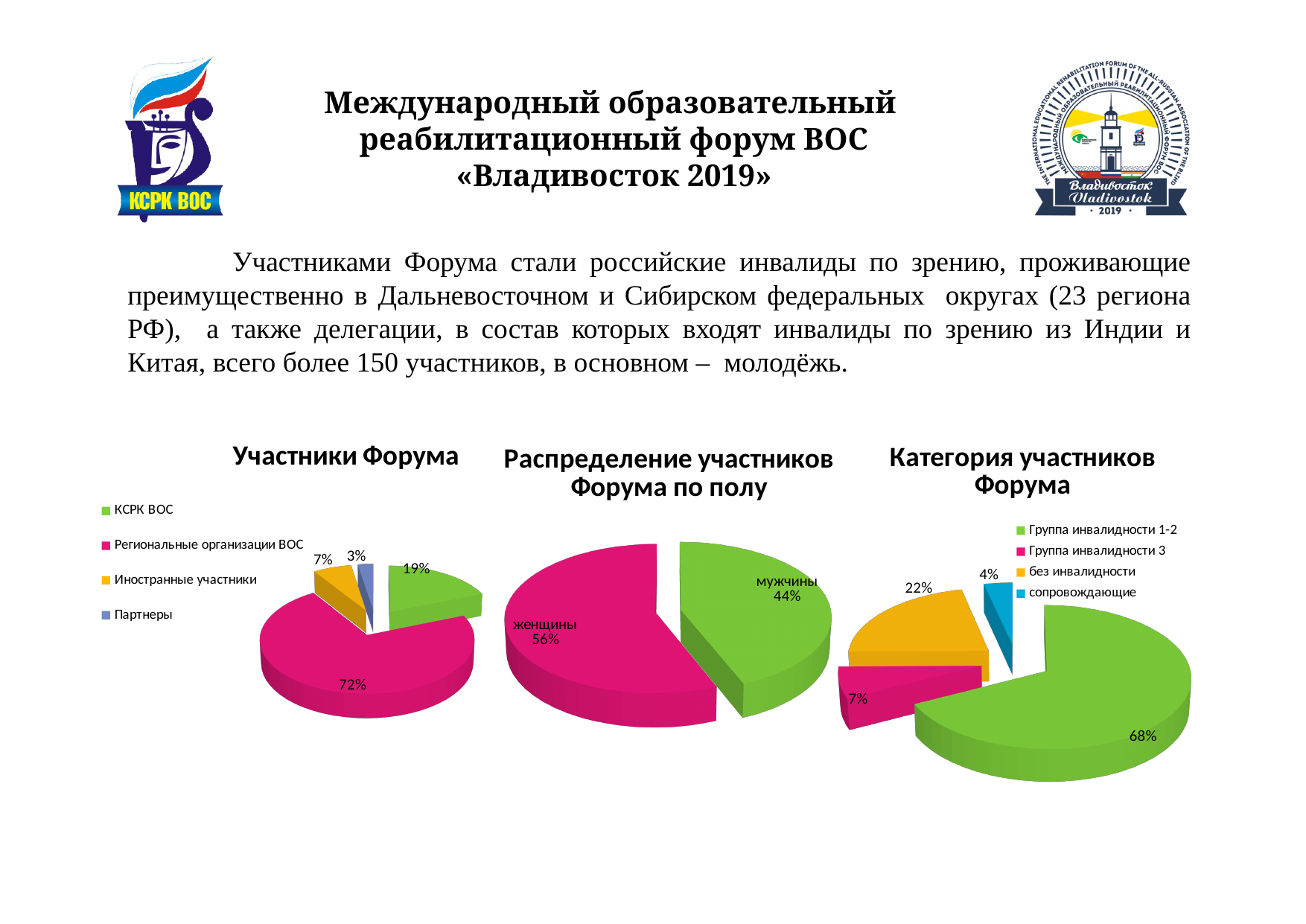
What kind of chart is «Категория участников Форума»? Pie chart In the chart titled «Распределение участников Форума по полу», what is the difference between the shares of «женщины» and «мужчины»? 12% In the chart titled «Участники Форума», what share is «КСРК ВОС»? 19% In the chart titled «Категория участников Форума», which category has the largest share? Группа инвалидности 1-2 In the chart titled «Участники Форума», how many categories does the legend list? 4 In the chart titled «Распределение участников Форума по полу», what share is «женщины»? 56% In the chart titled «Распределение участников Форума по полу», which group is larger, «мужчины» or «женщины»? женщины In the chart titled «Категория участников Форума», what share is «сопровождающие»? 4% In the chart titled «Участники Форума», what is the difference between the shares of «Иностранные участники» and «Партнеры»? 4% In the chart titled «Участники Форума», what share of participants is «Региональные организации ВОС»? 72% In the chart titled «Категория участников Форума», what share is «без инвалидности»? 22% In the chart titled «Участники Форума», which category has the smallest share? Партнеры